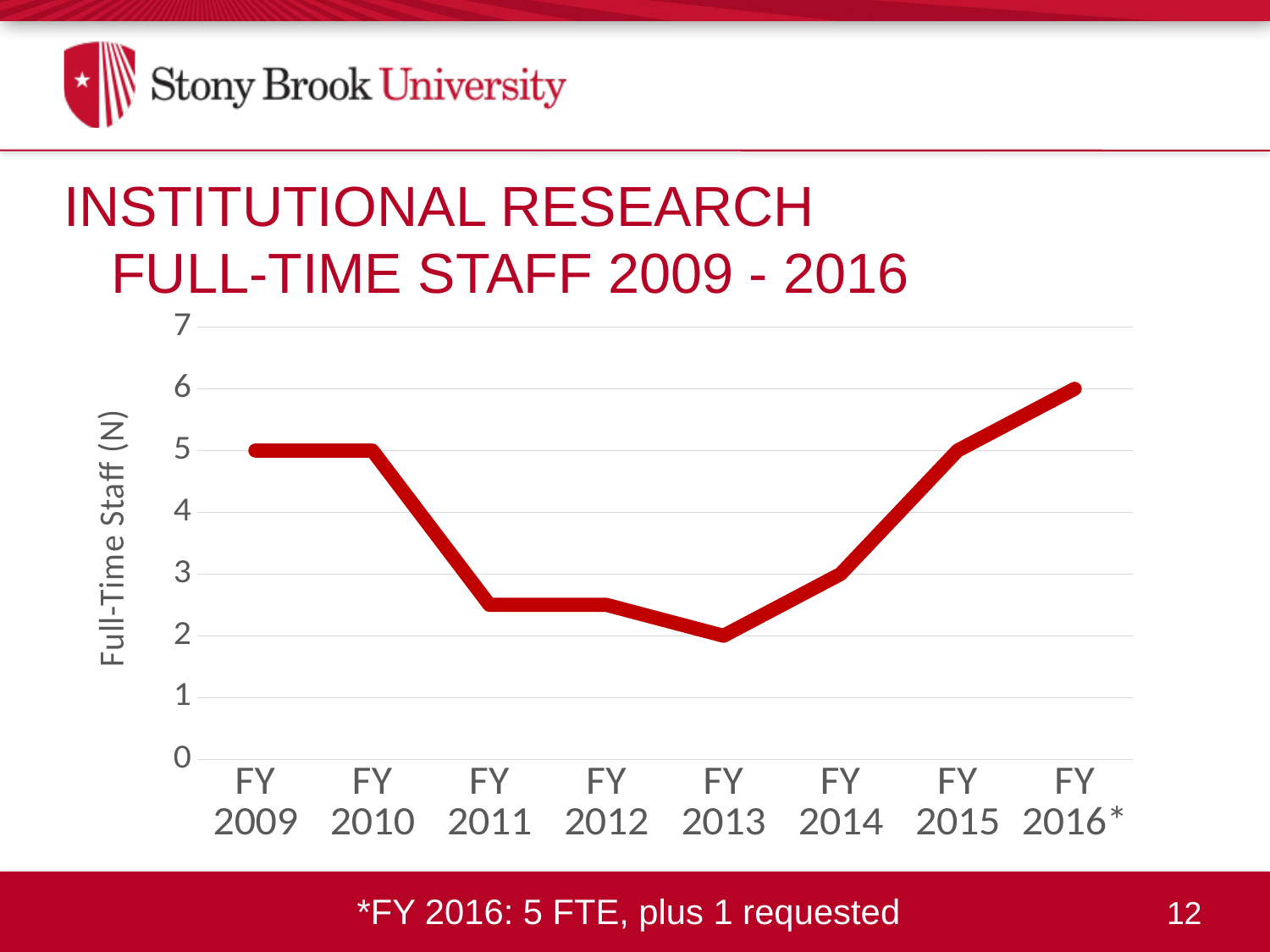
How many fiscal years are plotted on the x axis? 8 What is the number of full-time staff in FY 2009? 5 What type of chart is shown on the slide? Line chart Is the value for FY 2011 greater or less than 3? less What is the difference in full-time staff between FY 2016* and FY 2013? 4 What is the number of full-time staff in FY 2014? 3 What is the number of full-time staff in FY 2013? 2 Which fiscal year has the lowest number of full-time staff? FY 2013 What is the number of full-time staff in FY 2016*? 6 Which has more full-time staff, FY 2015 or FY 2014? FY 2015 Do the values rise or fall from FY 2013 to FY 2016*? Rise Which fiscal year has the highest number of full-time staff? FY 2016*